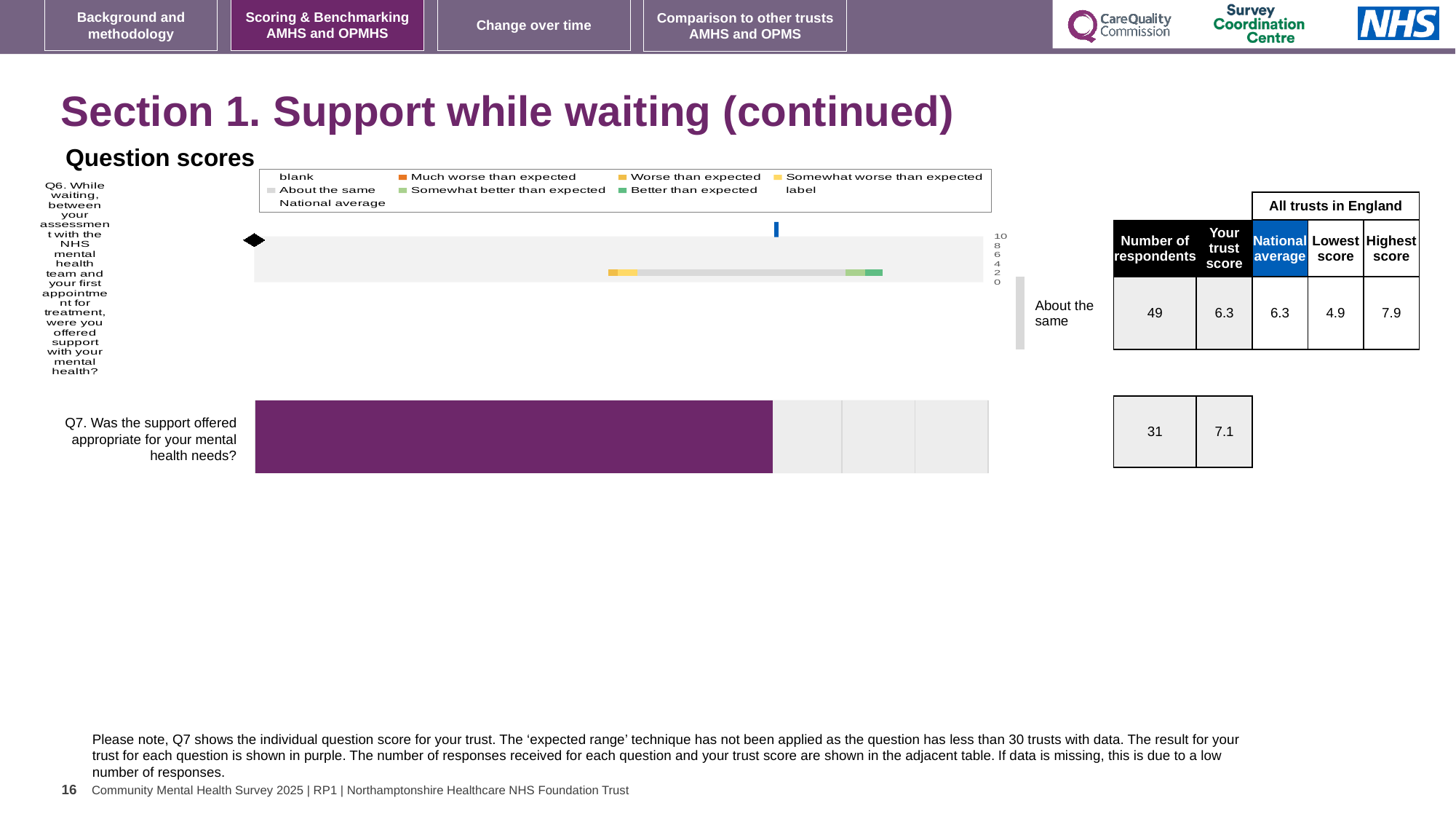
How many respondents answered Q7? 31 What is the national average score for Q6? 6.3 Which question has the higher trust score, Q6 or Q7? Q7 What is the trust score for Q7 (was the support offered appropriate for your mental health needs)? 7.1 What is the difference between the highest and lowest scores for Q6 across all trusts in England? 3.0 What is the highest score among all trusts in England for Q6? 7.9 What kind of chart is used to show the question scores on this slide? Bar chart What colour is the bar showing the trust's score for Q7? Purple Is the Q7 trust score bar greater or less than 6 on the chart's scale? greater What is the trust score for Q6 (support while waiting between assessment and first appointment)? 6.3 What is the number of respondents for Q6 shown in the table next to the chart? 49 What is the lowest score among all trusts in England for Q6? 4.9